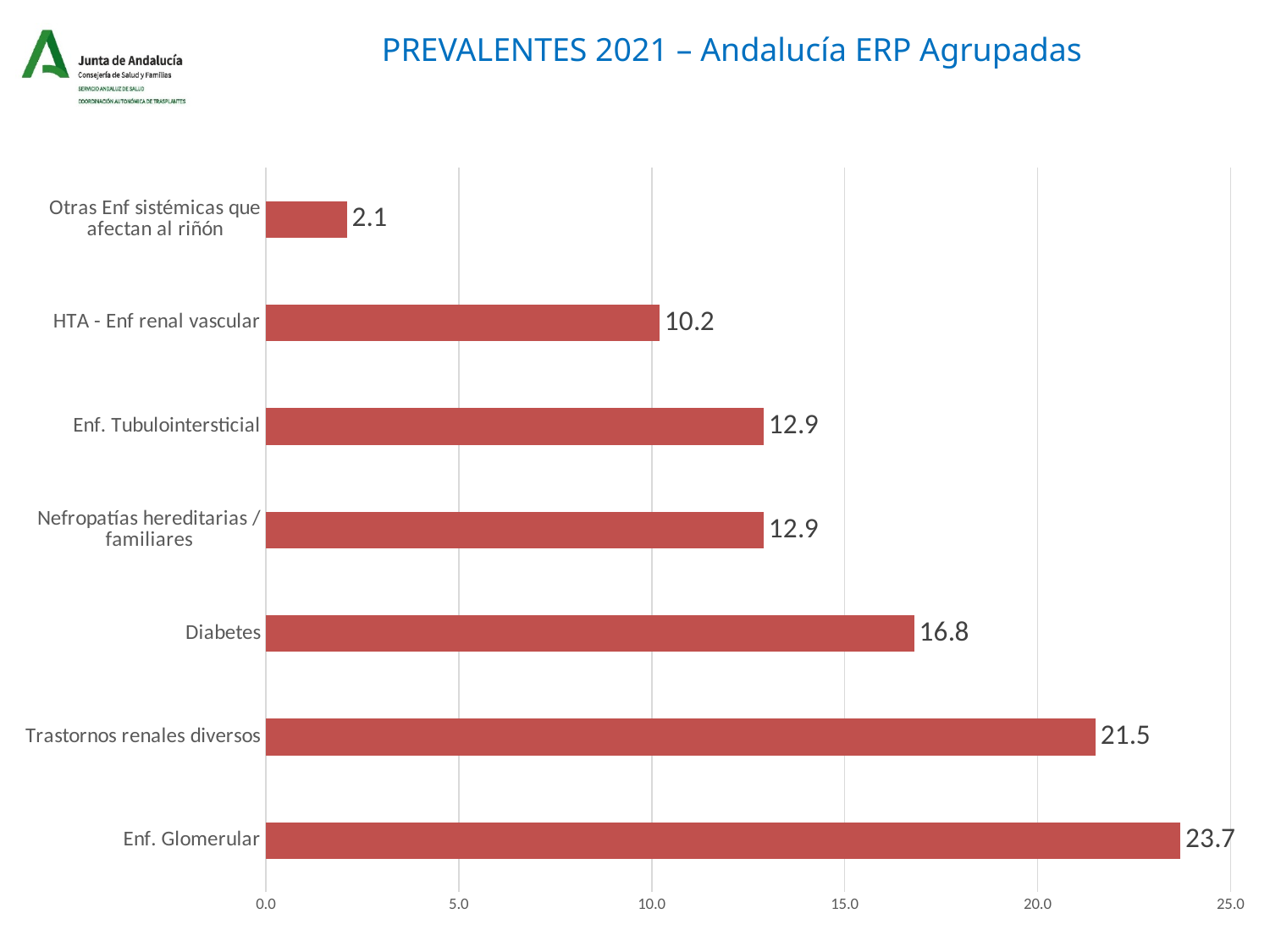
What is the value for Diabetes? 16.8 Is the value for Trastornos renales diversos greater or less than 20.0? greater What is the title of the chart? PREVALENTES 2021 – Andalucía ERP Agrupadas What kind of chart is shown on the slide? Bar chart How many categories are shown in the chart? 7 What is the difference between the values for Diabetes and HTA - Enf renal vascular? 6.6 Which category has the lowest value? Otras Enf sistémicas que afectan al riñón What is the value for HTA - Enf renal vascular? 10.2 Which is larger, the value for Diabetes or the value for Enf. Tubulointersticial? Diabetes What is the value for Enf. Glomerular? 23.7 What is the difference between the values for Enf. Glomerular and Trastornos renales diversos? 2.2 Which category has the highest value? Enf. Glomerular